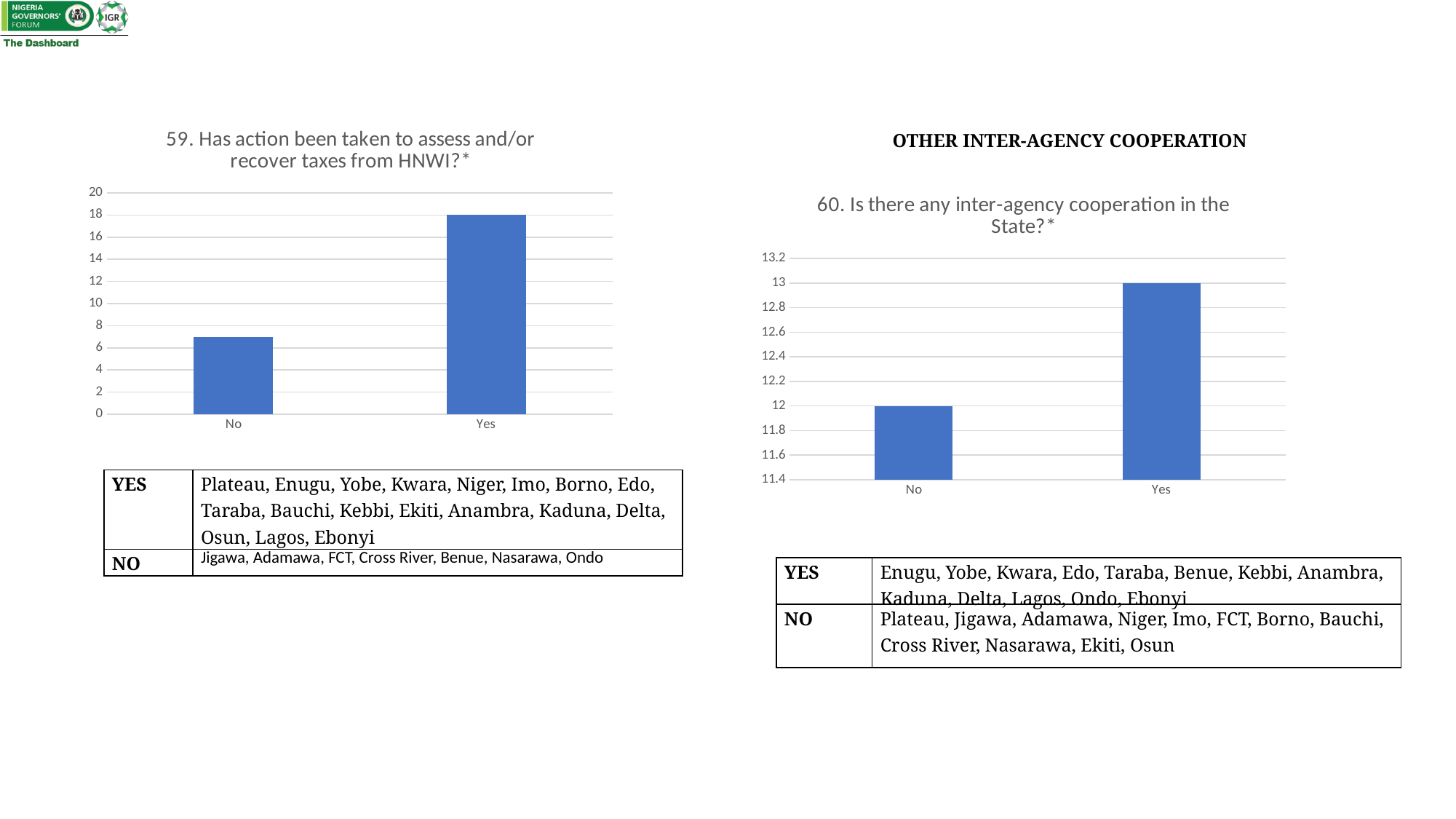
In the chart titled "60. Is there any inter-agency cooperation in the State?*", what is the value for No? 12 In the chart titled "59. Has action been taken to assess and/or recover taxes from HNWI?*", what is the value for Yes? 18 In the chart titled "60. Is there any inter-agency cooperation in the State?*", which category has the lowest value? No In the chart titled "60. Is there any inter-agency cooperation in the State?*", which is larger, the value for Yes or the value for No? Yes What kind of chart is the one titled "59. Has action been taken to assess and/or recover taxes from HNWI?*"? bar chart What is the heading printed above the right-hand chart on the slide? OTHER INTER-AGENCY COOPERATION In the chart titled "60. Is there any inter-agency cooperation in the State?*", what is the value for Yes? 13 In the chart titled "59. Has action been taken to assess and/or recover taxes from HNWI?*", which category has the highest value? Yes In the chart titled "59. Has action been taken to assess and/or recover taxes from HNWI?*", is the value for No greater or less than 8? less In the chart titled "59. Has action been taken to assess and/or recover taxes from HNWI?*", how many categories are shown on the x axis? 2 In the chart titled "60. Is there any inter-agency cooperation in the State?*", what is the difference between the values for Yes and No? 1 In the chart titled "60. Is there any inter-agency cooperation in the State?*", what is the highest value shown on the y axis? 13.2